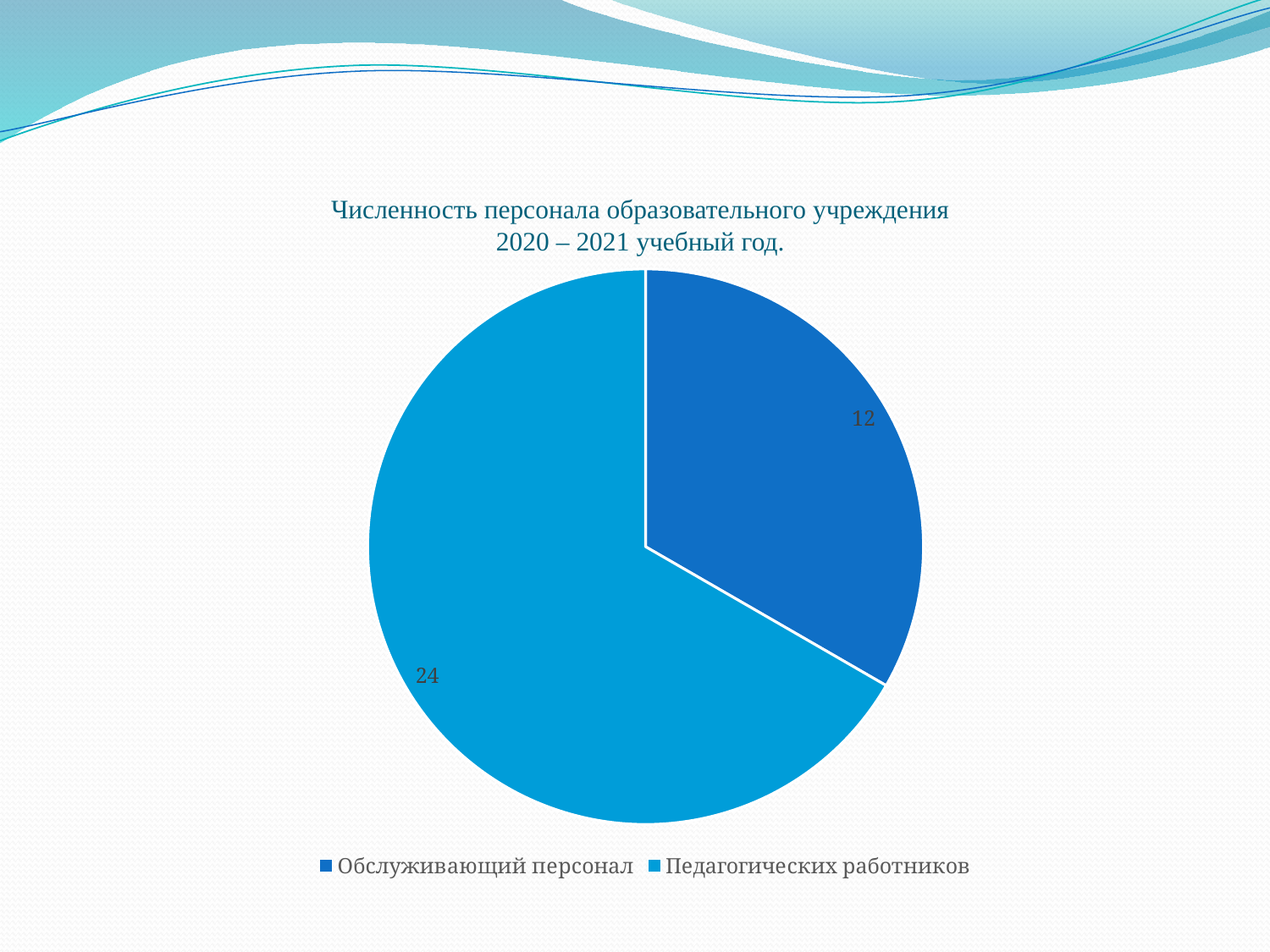
How many slices does the pie chart have? 2 What is the value for Обслуживающий персонал? 12 What is the total of all slices in the pie chart? 36 Which category has the largest slice of the pie? Педагогических работников Which category has the smallest slice of the pie? Обслуживающий персонал Which is larger, the value for Обслуживающий персонал or the value for Педагогических работников? Педагогических работников What share of the pie does Обслуживающий персонал represent? one third What is the difference between the values for Педагогических работников and Обслуживающий персонал? 12 How many entries does the legend list? 2 What is the title of the chart? Численность персонала образовательного учреждения 2020 – 2021 учебный год. What kind of chart is shown on the slide? pie chart What is the value for Педагогических работников? 24